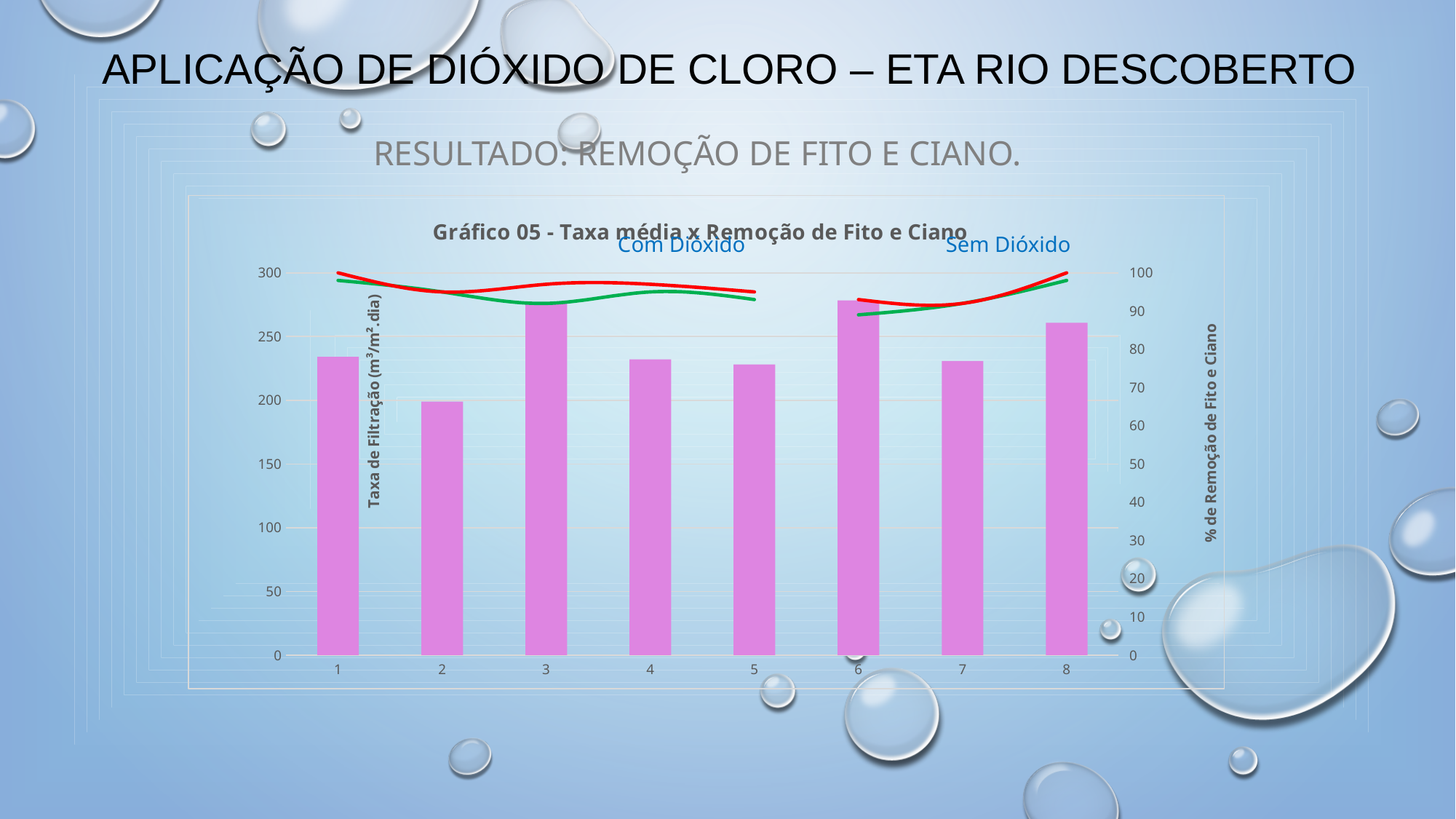
What is the highest tick value shown on the right vertical axis of the chart? 100 Which bar is taller, category 3 or category 2? 3 Is the bar for category 3 greater or less than 250? greater Which bar is taller, category 8 or category 7? 8 Is the bar for category 2 greater or less than 250? less What kind of chart is used to show the Taxa de Filtração values? bar chart Is the bar for category 1 greater or less than 250? less How many categories are shown on the x axis of the chart? 8 Which category has the lowest bar in the chart? 2 What is the title of the chart? Gráfico 05 - Taxa média x Remoção de Fito e Ciano What is the title of the left vertical axis of the chart? Taxa de Filtração (m³/m².dia)